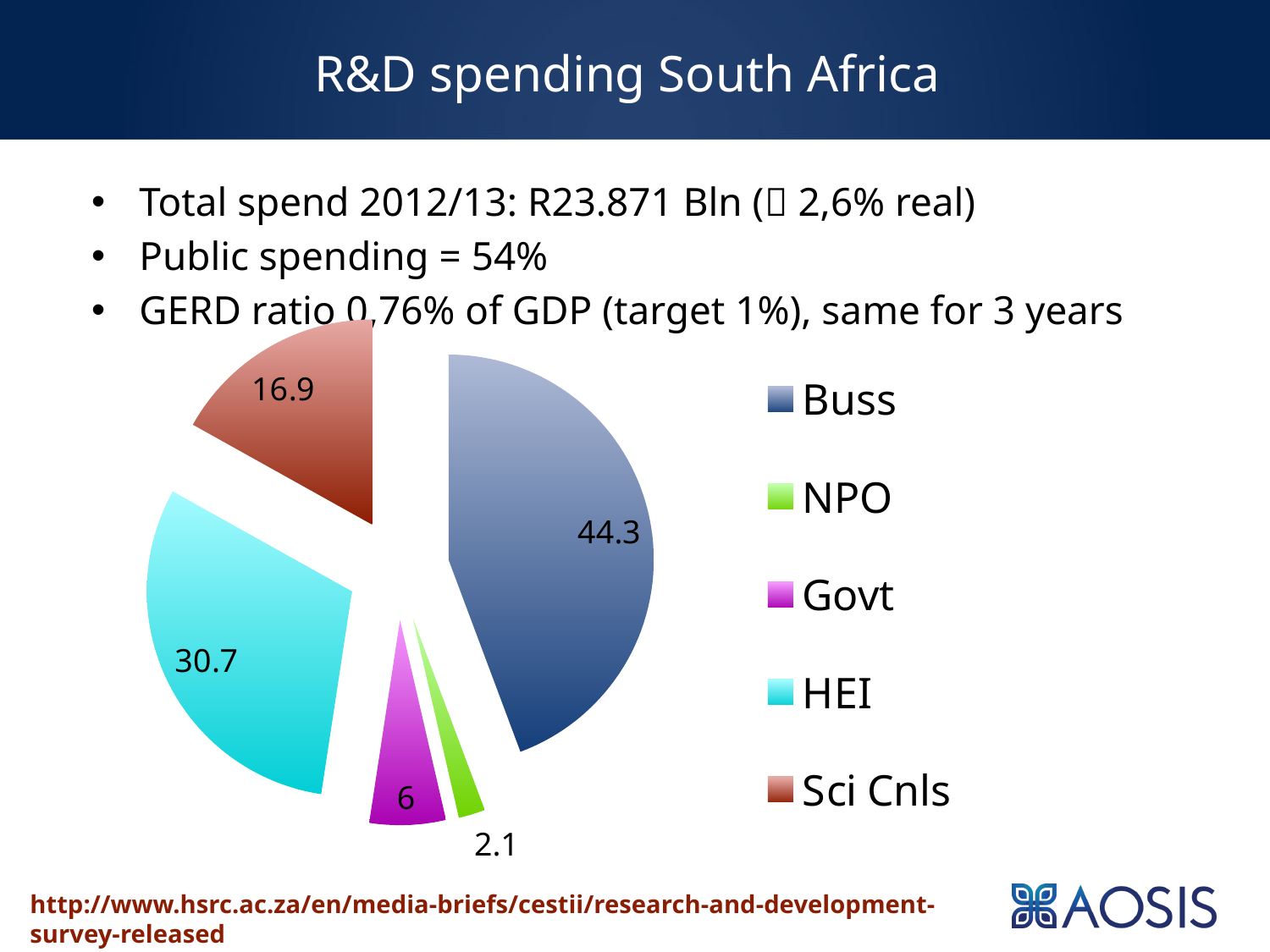
Which category has the smallest slice of the pie chart? NPO What is the value for NPO in the pie chart? 2.1 What is the value for Buss in the pie chart? 44.3 What colour is the HEI slice in the pie chart? cyan Which category has the largest slice of the pie chart? Buss How many categories does the legend of the pie chart list? 5 What kind of chart is shown on the slide? pie chart What is the value for Sci Cnls in the pie chart? 16.9 What is the value for Govt in the pie chart? 6 What is the value for HEI in the pie chart? 30.7 Which is larger, the value for Govt or the value for Sci Cnls? Sci Cnls What is the difference between the values for Buss and HEI? 13.6